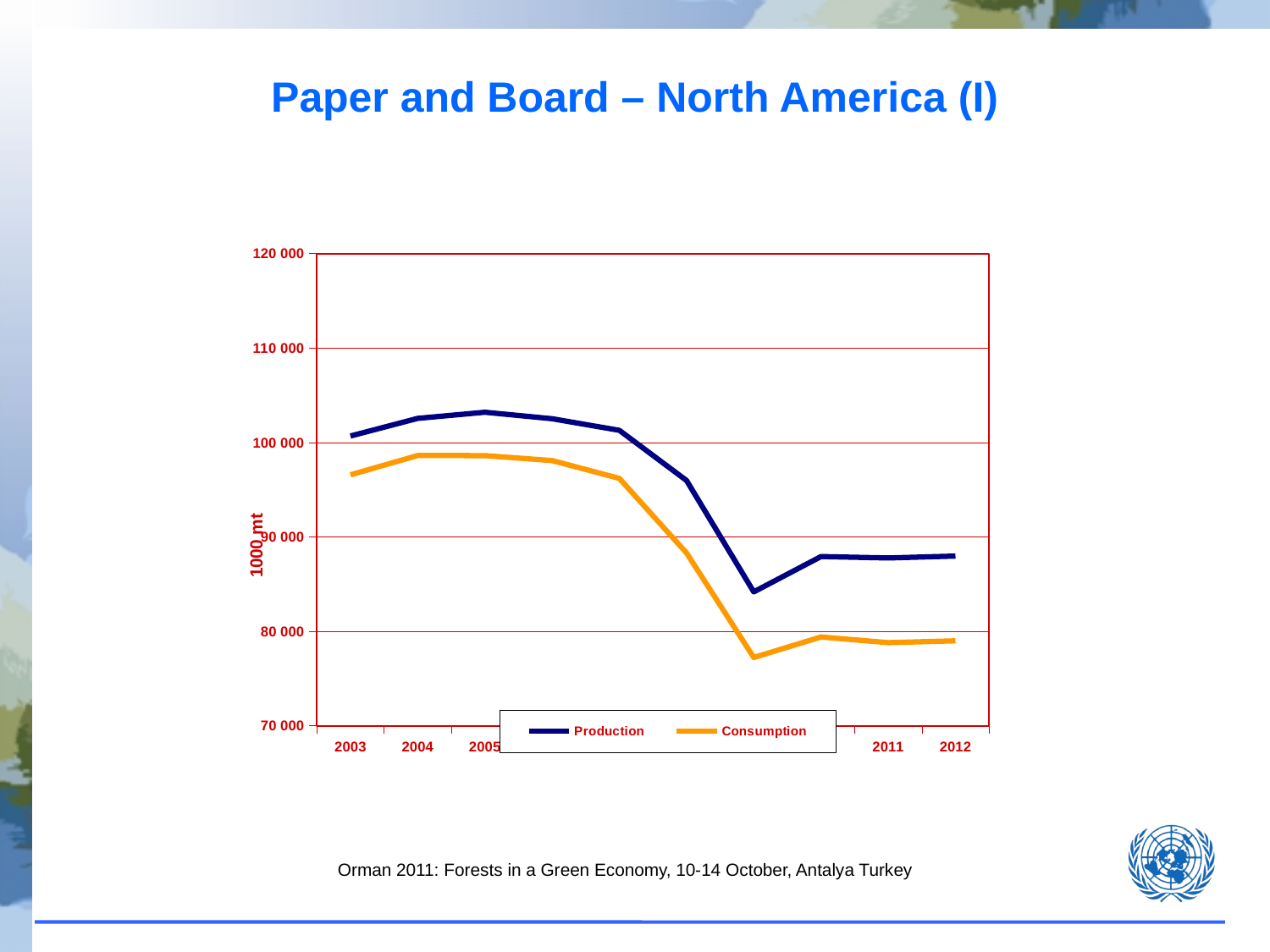
Is the Consumption value for 2003 greater or less than 100 000? less What is the title of the slide containing the chart? Paper and Board – North America (I) Is the Production value for 2004 greater or less than 100 000? greater Does Consumption overall rise or fall from 2003 to 2012? fall In which labelled year does Production reach its highest value? 2005 How many series does the legend list? 2 What unit is shown on the vertical axis label? 1000 mt In 2012, which is larger, Production or Consumption? Production Is the Production value for 2005 greater or less than 100 000? greater What kind of chart is shown on the slide? line chart